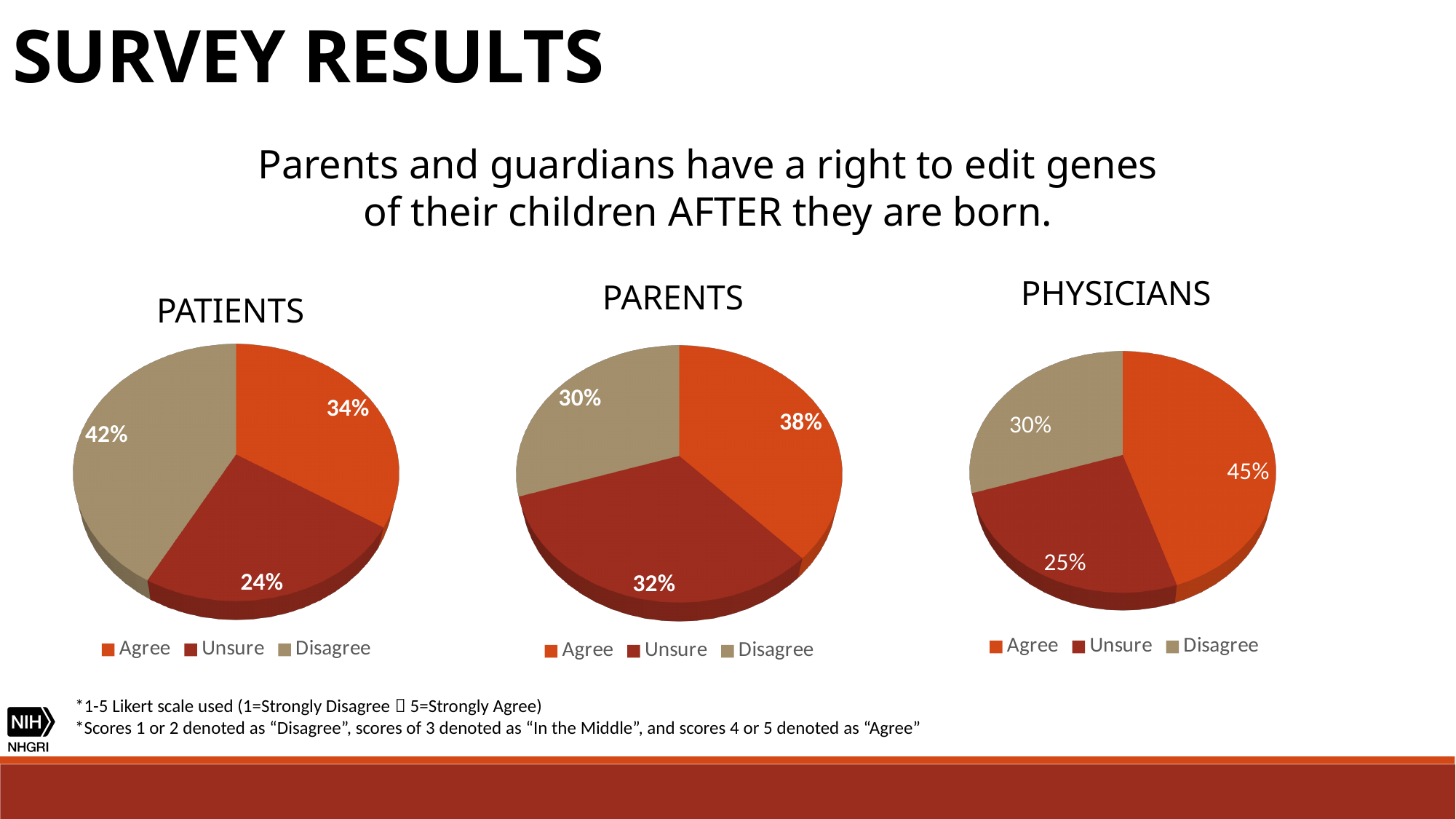
In the PARENTS pie chart, which response has the largest share? Agree How many slices does the PARENTS pie chart have? 3 In the PHYSICIANS pie chart, which response has the smallest share? Unsure In the PHYSICIANS pie chart, what percentage of respondents chose Disagree? 30% In the PARENTS pie chart, what percentage of respondents chose Unsure? 32% What kind of chart is used for the PHYSICIANS data? Pie chart In the PATIENTS pie chart, which response has the largest share? Disagree Which group has a larger Agree share, PATIENTS or PHYSICIANS? PHYSICIANS In the PATIENTS pie chart, what is the difference between the Disagree and Agree percentages? 8% What are the three legend entries shown under the PATIENTS chart? Agree, Unsure, Disagree In the PATIENTS pie chart, what percentage of respondents chose Agree? 34% In the PHYSICIANS pie chart, what is the difference between the Agree and Unsure percentages? 20%